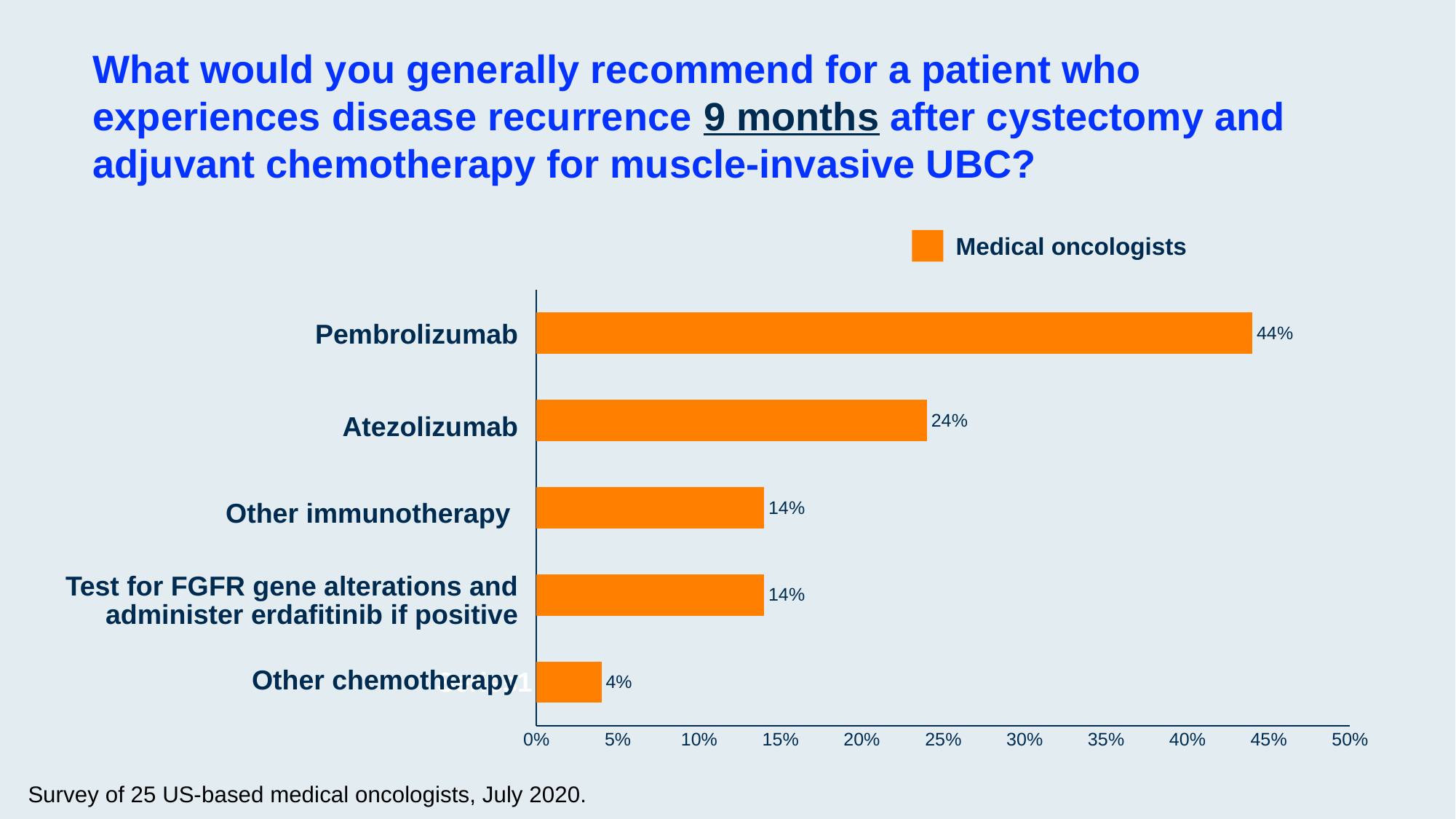
How many categories are shown in the chart? 5 Which option has the lowest percentage? Other chemotherapy What is the value for 'Test for FGFR gene alterations and administer erdafitinib if positive'? 14% Which is larger, the value for Atezolizumab or the value for Other immunotherapy? Atezolizumab What is the value for Atezolizumab? 24% What is the difference between the values for Pembrolizumab and Atezolizumab? 20% How many series does the legend list? 1 What percentage of medical oncologists would recommend Pembrolizumab? 44% What percentage is shown for Other chemotherapy? 4% Which option has the highest percentage? Pembrolizumab What is the legend entry for the series shown in the chart? Medical oncologists What kind of chart is shown on the slide? Bar chart